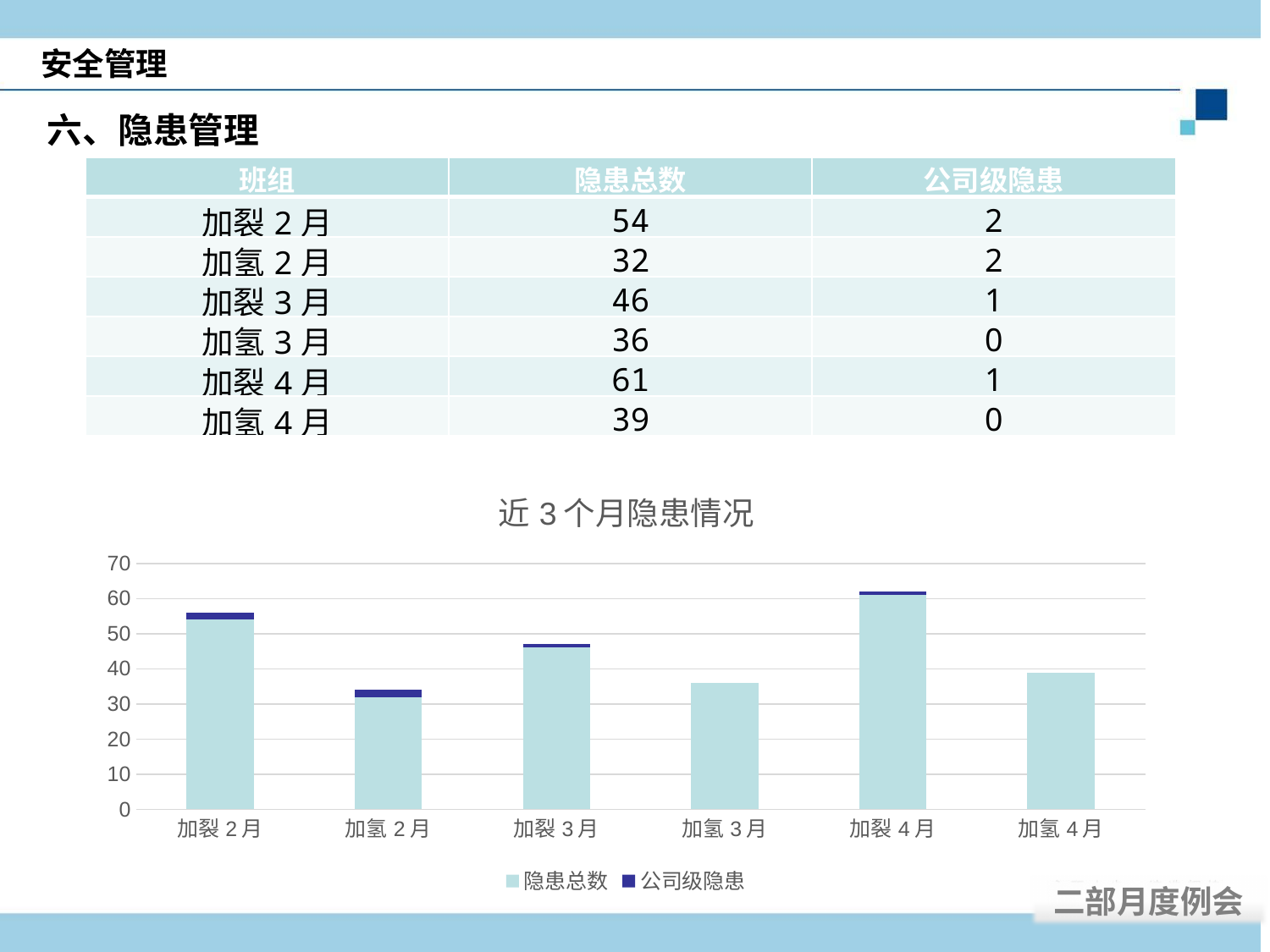
What is the 公司级隐患 value for 加氢 3 月? 0 How many series does the chart legend list? 2 What is the total of the stacked bar for 加裂 2 月 (隐患总数 plus 公司级隐患)? 56 Which category has the highest 隐患总数 in the chart? 加裂 4 月 How many categories are shown on the x axis of the chart? 6 Is the value for 加氢 3 月 greater or less than 40? less Is the 隐患总数 value for 加裂 4 月 greater or less than 60? greater Which has a larger 隐患总数, 加裂 2 月 or 加氢 2 月? 加裂 2 月 What kind of chart is shown on the slide? bar chart What is the difference in 隐患总数 between 加裂 4 月 and 加裂 2 月? 7 What is the 隐患总数 value for 加裂 3 月? 46 What is the title of the chart? 近 3 个月隐患情况